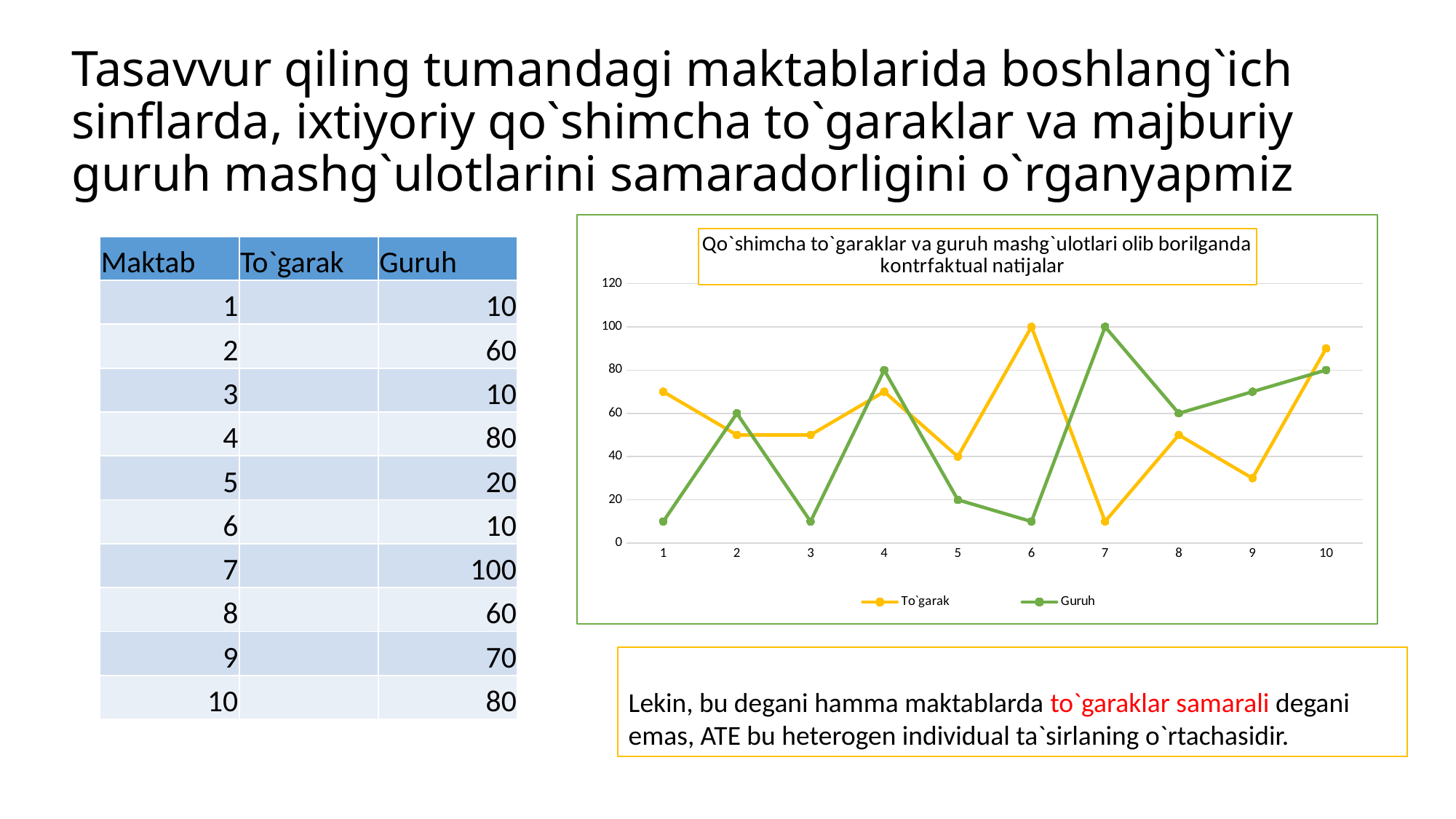
What are the two series names listed in the chart legend? To`garak and Guruh What is the Guruh value for school 7 in the chart? 100 At school 7, which series has the larger value, To`garak or Guruh? Guruh For which school is the Guruh series highest? 7 Is the To`garak value for school 1 greater or less than 60? greater What kind of chart is shown on the slide? line chart How many schools (points) are plotted along the x axis of the chart? 10 For which school is the To`garak series lowest? 7 How many series does the chart legend list? 2 What is the Guruh value for school 5 in the chart? 20 What is the difference between the To`garak and Guruh values at school 6? 90 What is the To`garak value for school 6 in the chart? 100